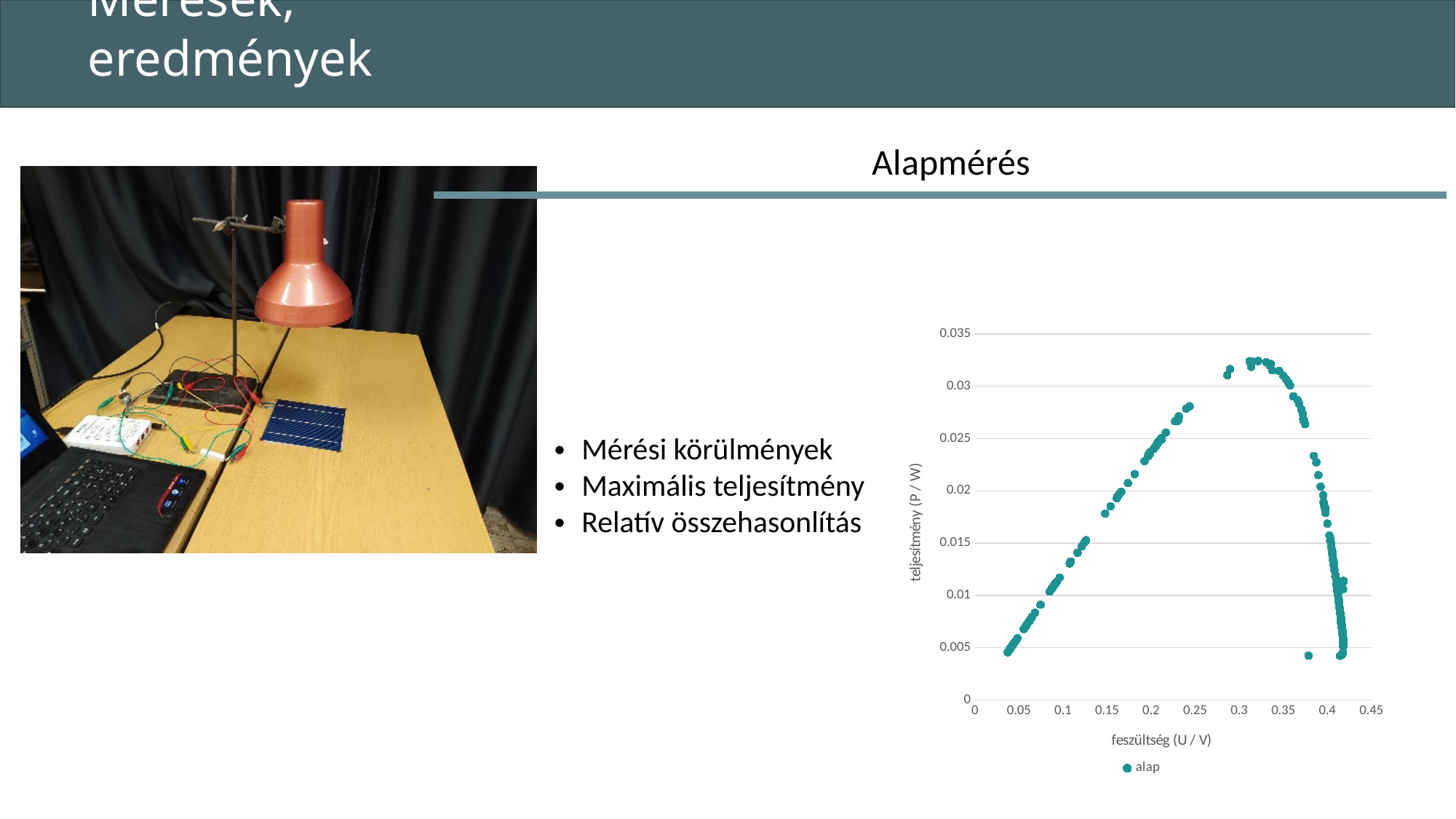
In the "Alapmérés" chart, is the highest plotted power value greater or less than 0.035? less In the "Alapmérés" chart, is the lowest plotted power value greater or less than 0.005? less In the "Alapmérés" chart, do the values rise or fall as the voltage increases from 0.05 to 0.25? rise In the "Alapmérés" chart, is the highest plotted power value greater or less than 0.03? greater What is the x-axis title of the "Alapmérés" chart? feszültség (U / V) How many series does the legend of the "Alapmérés" chart list? 1 What is the name of the series shown in the legend of the "Alapmérés" chart? alap In the "Alapmérés" chart, which is larger: the power value at a voltage of 0.3 or at a voltage of 0.1? at 0.3 What kind of chart is shown under the title "Alapmérés"? scatter chart In the "Alapmérés" chart, do the values rise or fall as the voltage increases from 0.35 to 0.4? fall